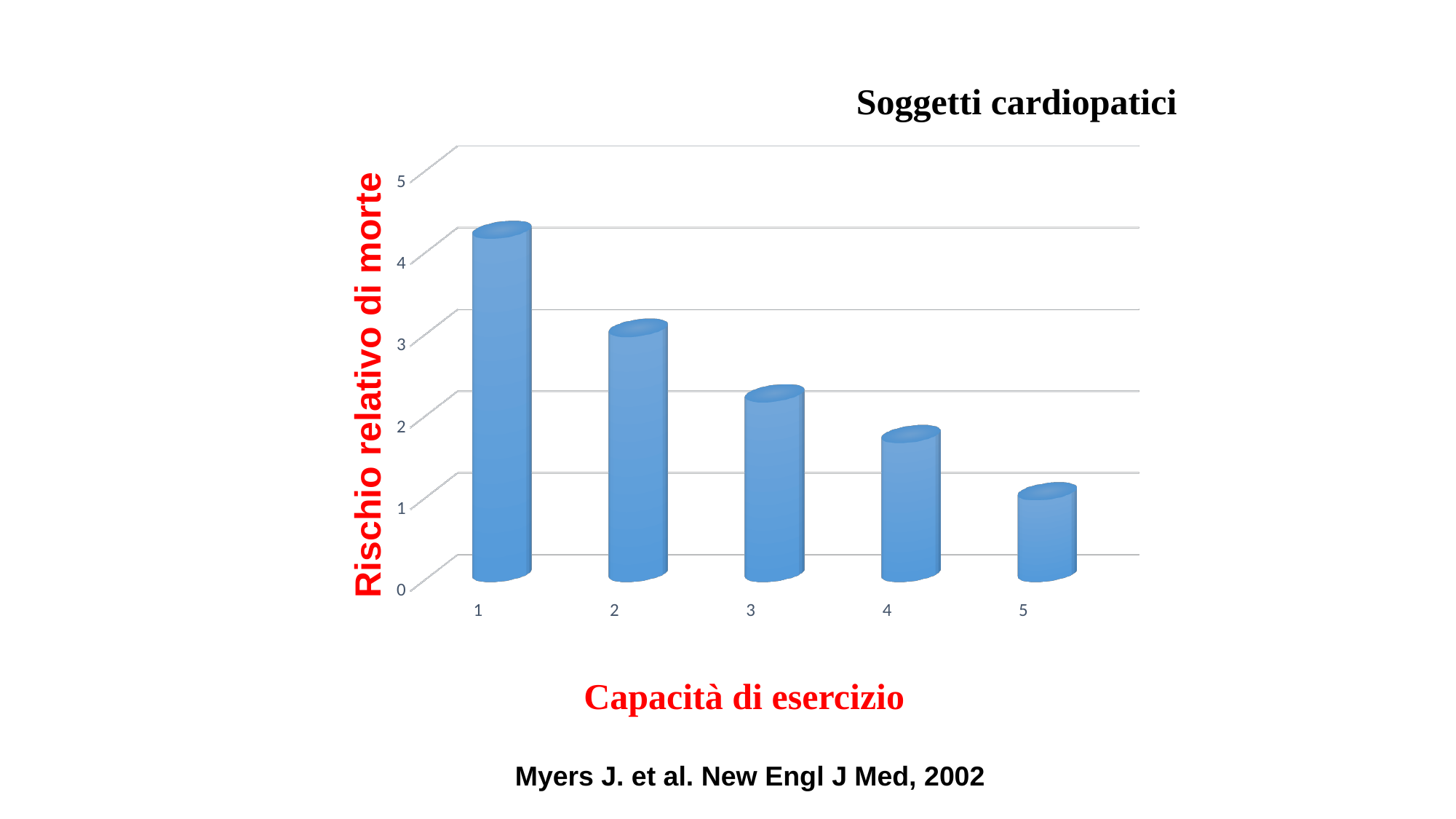
Which has a larger relative risk of death, category 2 or category 4? 2 Do the values rise or fall as exercise capacity increases from 1 to 5? fall How many categories are plotted on the x axis? 5 Is the value for category 3 greater or less than 3? less What is the label of the vertical axis? Rischio relativo di morte Which exercise capacity category has the lowest relative risk of death? 5 Which has a larger relative risk of death, category 1 or category 5? 1 Is the value for category 1 greater or less than 3? greater What is the title of the chart? Soggetti cardiopatici Which exercise capacity category has the highest relative risk of death? 1 Is the value for category 5 greater or less than 2? less What kind of chart is shown on the slide? bar chart